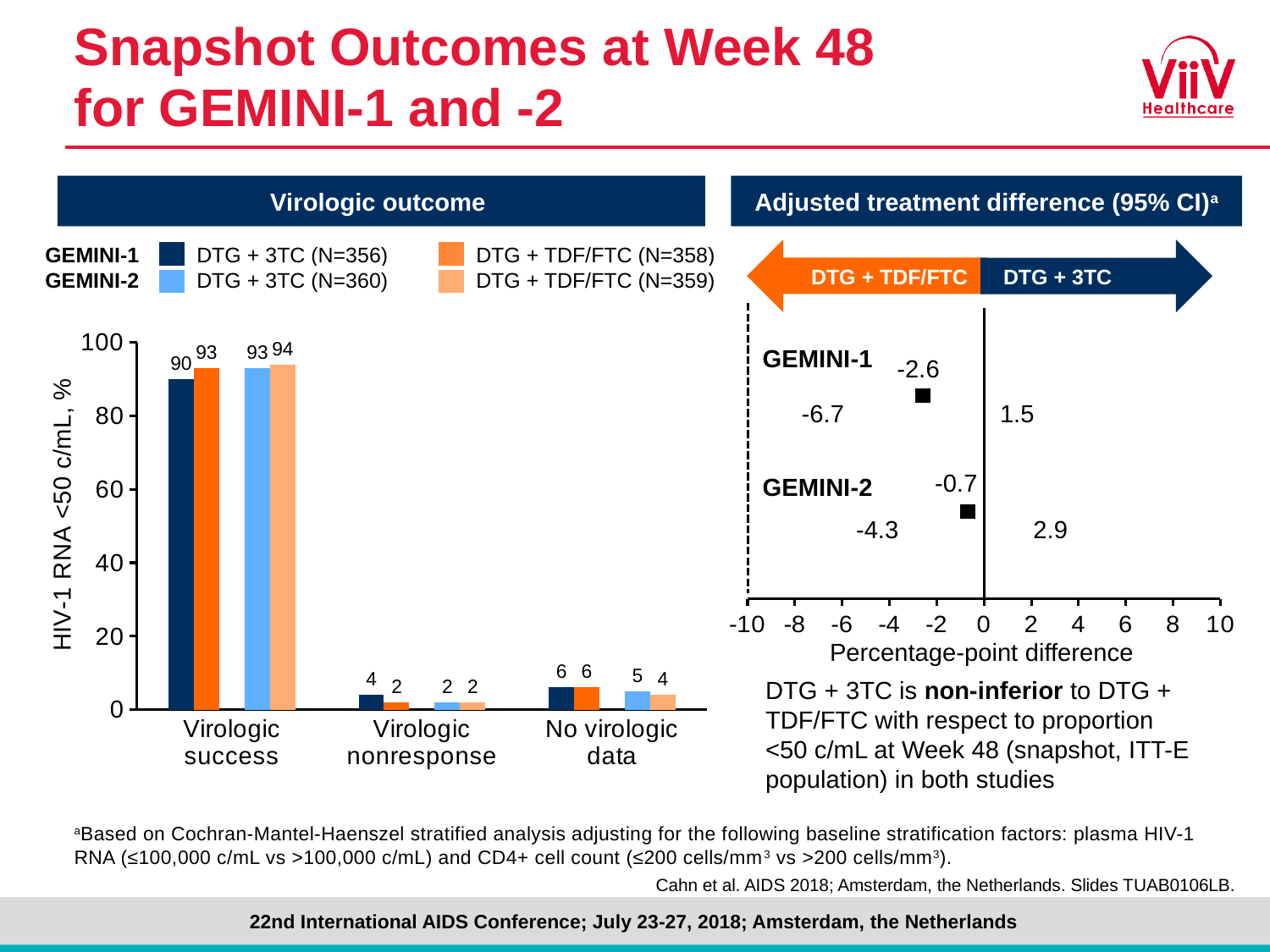
In the Virologic outcome chart, how many outcome categories are shown on the x axis? 3 In the Virologic outcome chart, which series has the highest virologic success rate? DTG + TDF/FTC (N=359), GEMINI-2 In the Virologic outcome chart, what is the virologic success rate for DTG + 3TC in GEMINI-1? 90 What kind of chart is the Virologic outcome chart? Bar chart In the Adjusted treatment difference chart, what is the upper bound of the 95% CI for GEMINI-2? 2.9 In the Adjusted treatment difference chart, what is the lower bound of the 95% CI for GEMINI-1? -6.7 In the Virologic outcome chart, how many series does the legend list? 4 In the Virologic outcome chart, what is the virologic nonresponse value for DTG + 3TC in GEMINI-1? 4 In the Adjusted treatment difference chart, what is the adjusted treatment difference for GEMINI-1? -2.6 In the Virologic outcome chart, which series has the lowest value for no virologic data? DTG + TDF/FTC (N=359), GEMINI-2 In the Virologic outcome chart, what is the virologic success rate for DTG + TDF/FTC in GEMINI-2? 94 In the Virologic outcome chart, what is the difference in virologic success between DTG + TDF/FTC and DTG + 3TC in GEMINI-1? 3